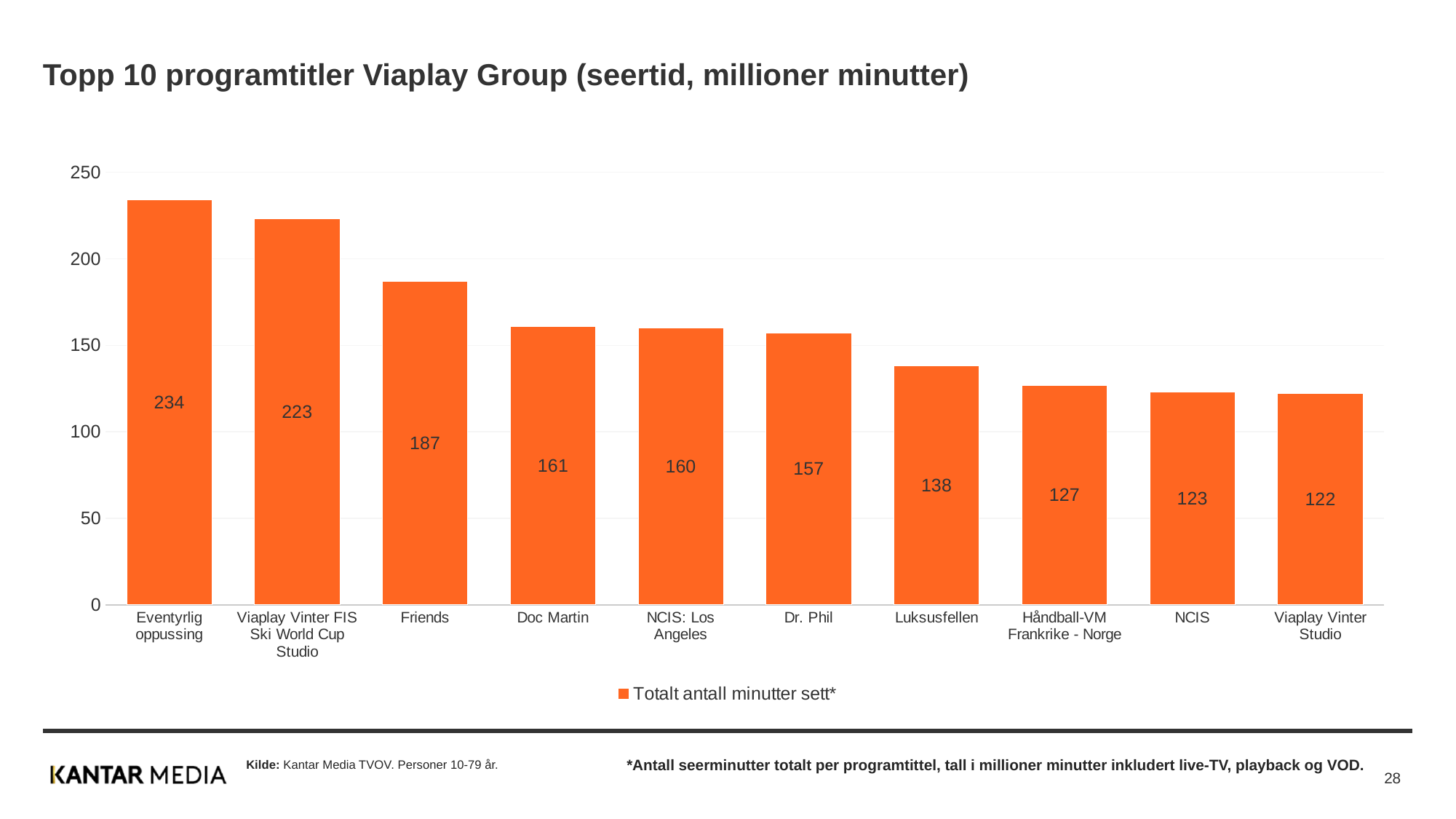
What is the value for Friends? 187 What is the legend entry for the series shown? Totalt antall minutter sett* What kind of chart is shown on the slide? Bar chart Which has a larger value, Friends or Dr. Phil? Friends Which program title has the highest value? Eventyrlig oppussing What is the value for Luksusfellen? 138 Is the value for Doc Martin greater or less than 150? greater What is the difference between the values for Eventyrlig oppussing and Viaplay Vinter FIS Ski World Cup Studio? 11 What is the value for Håndball-VM Frankrike - Norge? 127 Which program title has the lowest value? Viaplay Vinter Studio How many series does the legend list? 1 How many program titles are shown in the chart? 10